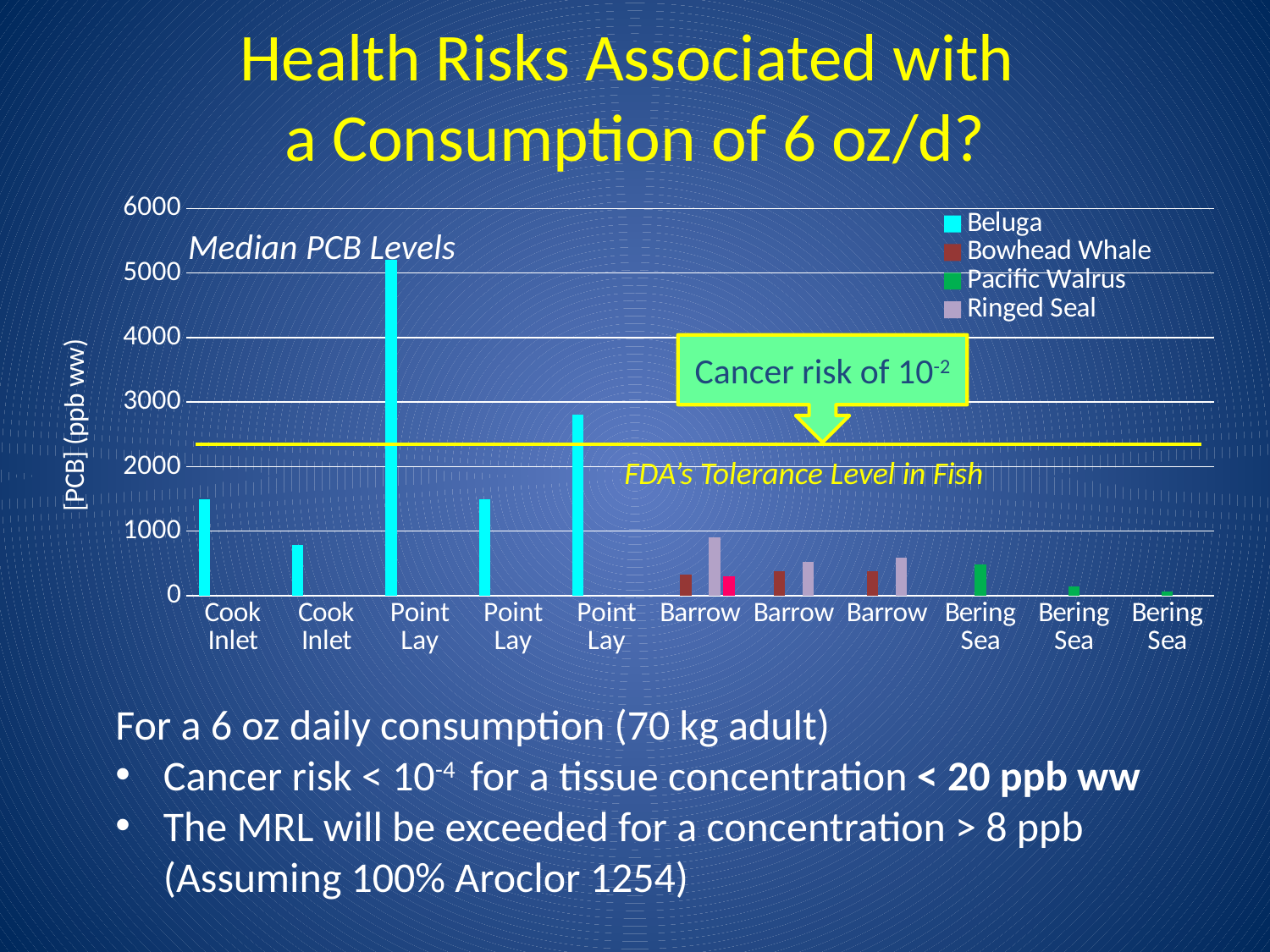
Is the Ringed Seal value for the first Barrow group greater or less than 1000? less Is the tallest Beluga bar at Point Lay greater or less than 5000? greater What kind of chart is shown on the slide? Bar chart How many category labels are shown along the x axis of the chart? 11 How many series does the chart legend list? 4 Which location has the tallest bar in the chart? Point Lay Is the Beluga value for the second Cook Inlet bar greater or less than 1000? less Which is larger, the Beluga bar for the first Cook Inlet or the Beluga bar for the second Cook Inlet? The first Cook Inlet What is the label on the y axis of the chart? [PCB] (ppb ww) Which series has the tallest bar in the chart? Beluga